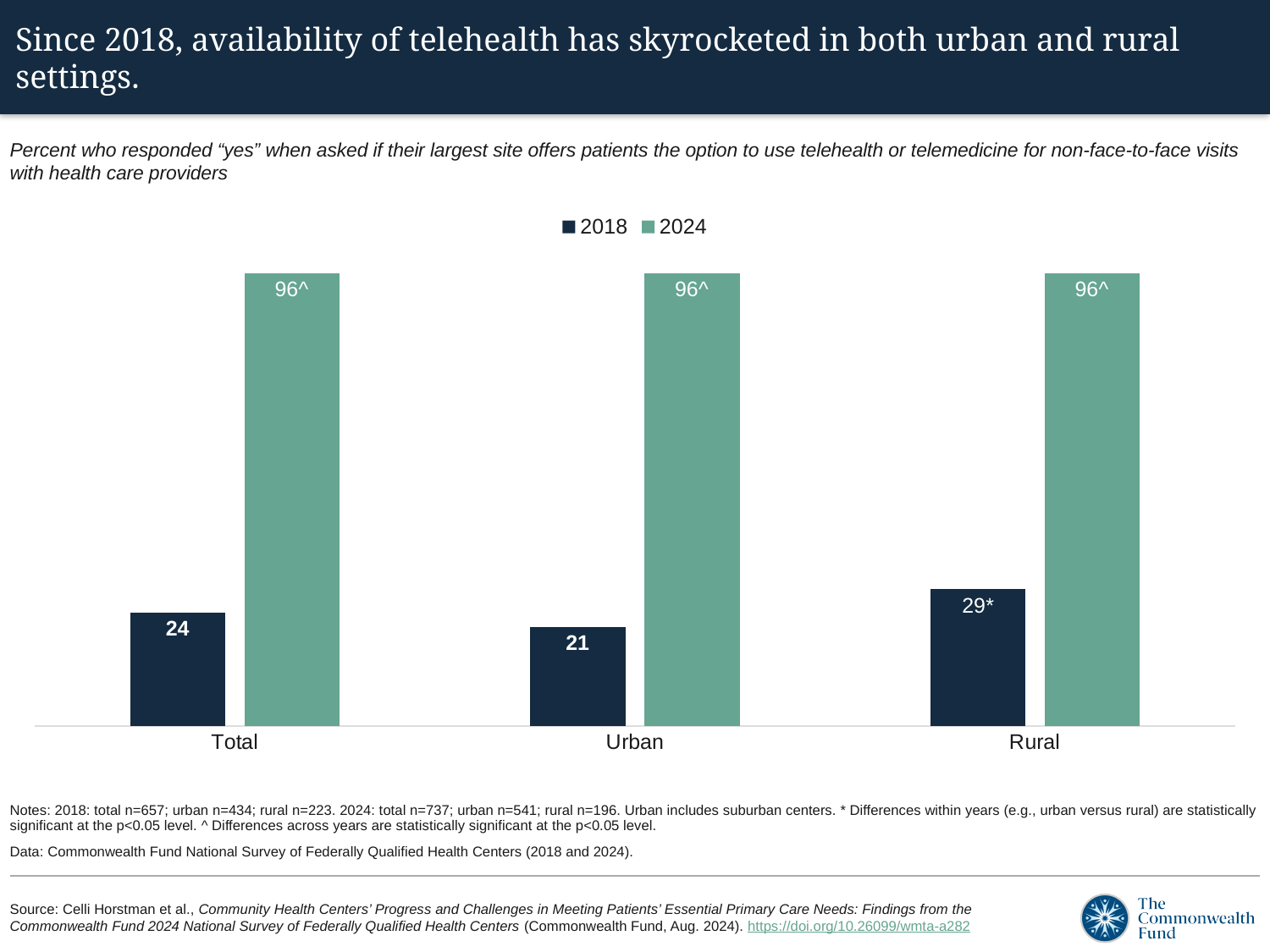
How many series does the legend list? 2 What kind of chart is shown on the slide? Bar chart Which is larger, the 2018 value for Rural or the 2018 value for Total? Rural What is the 2024 value for Urban? 96^ Which category has the highest 2018 value? Rural What is the 2018 value for Urban? 21 How many categories are shown on the x axis? 3 What is the 2018 value for Total? 24 What is the difference between the 2018 values for Rural and Urban? 8 What is the 2018 value for Rural? 29* What is the difference between the 2024 and 2018 values for Total? 72 Which category has the lowest 2018 value? Urban